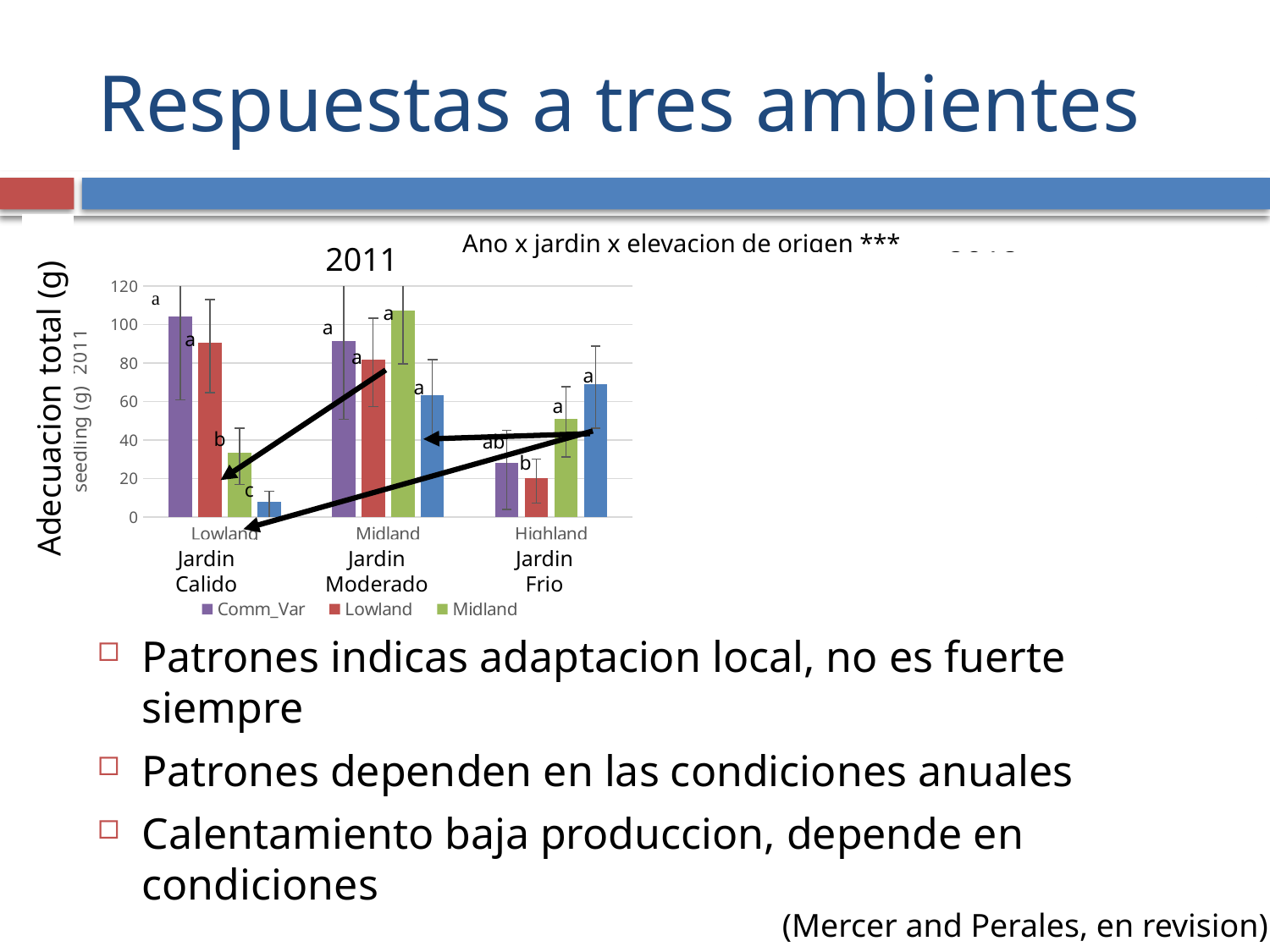
Is the Comm_Var value larger in the Lowland category or in the Highland category? Lowland What kind of chart is shown on the slide? bar chart Which series has the highest value in the Lowland category? Comm_Var Is the value for Comm_Var in the Lowland category greater or less than 100? greater Which series has the highest value in the Midland category? Midland How many categories are shown on the x axis of the chart? 3 What is the label on the vertical axis of the chart? Adecuacion total (g) Is the value for the Midland series in the Lowland category greater or less than 40? less Is the value for the Lowland series in the Lowland category greater or less than 80? greater What is the title shown above the chart? 2011